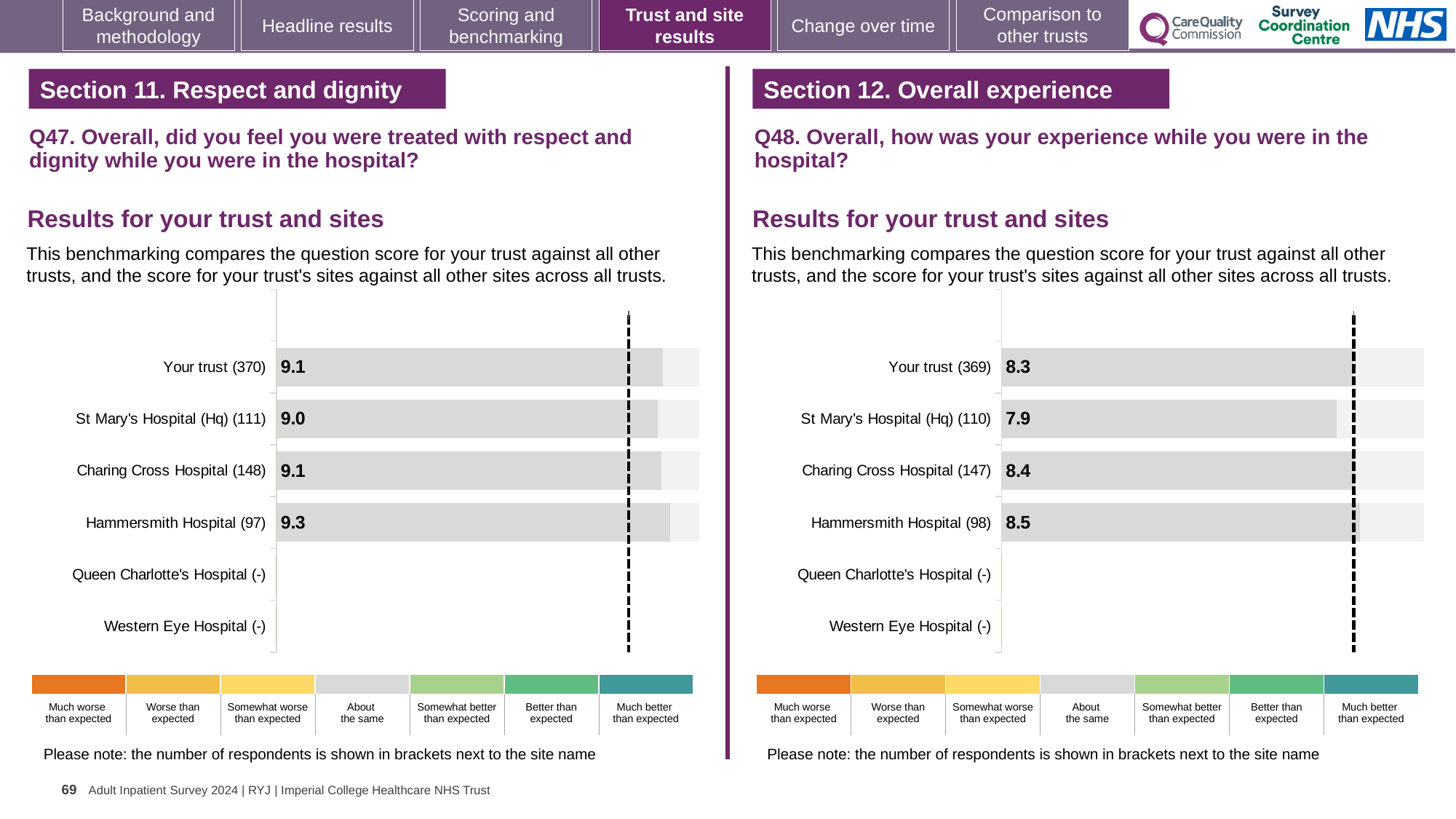
In the Q48 chart on the right, what is the score for St Mary's Hospital (Hq) (110)? 7.9 In the Q48 chart on the right, what is the score for Hammersmith Hospital (98)? 8.5 In the Q47 chart on the left, what is the score for Charing Cross Hospital (148)? 9.1 In the Q48 chart on the right, which has the higher score: Charing Cross Hospital (147) or St Mary's Hospital (Hq) (110)? Charing Cross Hospital (147) In the Q47 chart on the left, what is the difference between the scores for Hammersmith Hospital (97) and St Mary's Hospital (Hq) (111)? 0.3 In the Q47 chart on the left, which site has the highest score? Hammersmith Hospital (97) In the Q48 chart on the right, what is the difference between the scores for Hammersmith Hospital (98) and St Mary's Hospital (Hq) (110)? 0.6 How many rows (trust and sites) are listed in the Q48 chart on the right? 6 In the Q47 chart on the left, how many sites have a plotted score bar? 3 In the Q48 chart on the right, which site has the lowest score among those with a plotted value? St Mary's Hospital (Hq) (110) What kind of chart is used for the Q47 results on the left? Bar chart In the Q47 chart on the left, what is the score for Your trust (370)? 9.1